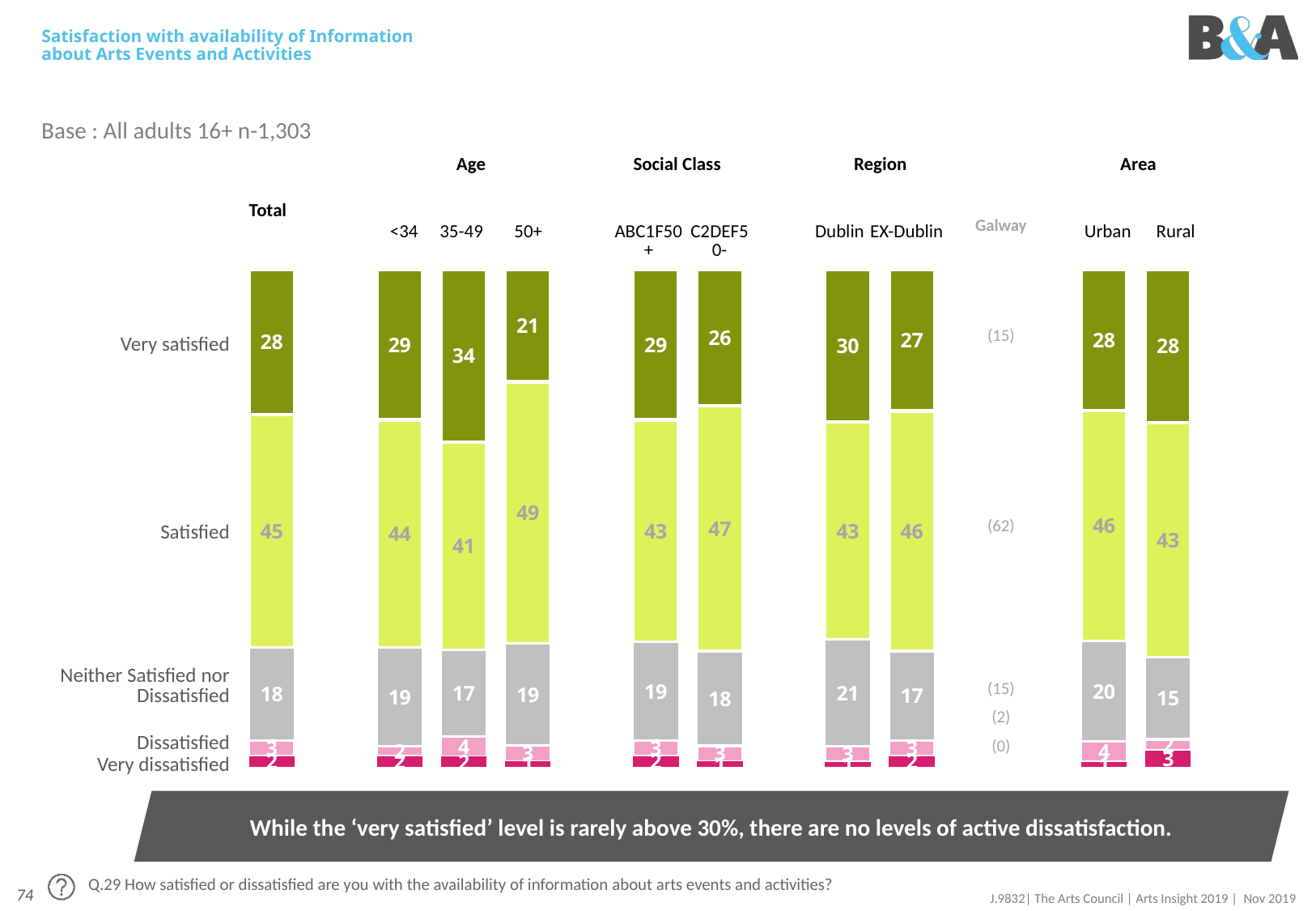
What is the difference between the 'Neither Satisfied nor Dissatisfied' values for Urban and Rural? 5 What is the 'Satisfied' value for Rural? 43 What is the 'Neither Satisfied nor Dissatisfied' value for Dublin? 21 Which age group has the highest 'Very satisfied' value? 35-49 What is the 'Very satisfied' value for the Total bar? 28 What kind of chart is shown on the slide? Stacked bar chart Which has a higher 'Very satisfied' value, Dublin or EX-Dublin? Dublin What is the base stated for the chart? All adults 16+ n-1,303 What is the difference between the 'Satisfied' values for C2DEF50- and ABC1F50+? 4 Which age group has the lowest 'Very satisfied' value? 50+ What is the 'Satisfied' value for the 50+ age group? 49 What is the 'Very satisfied' value shown for Galway? (15)